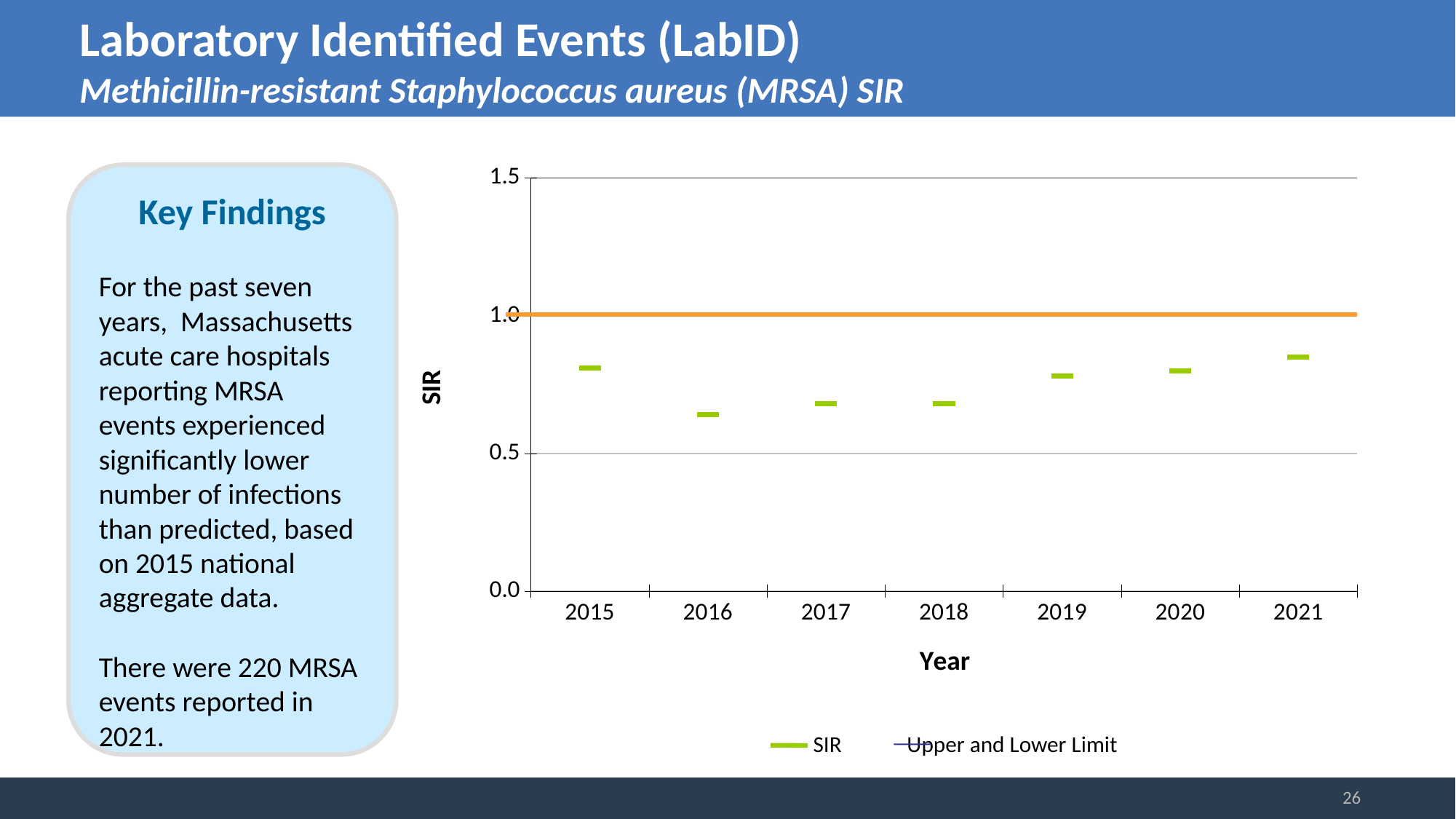
Is the SIR value for 2021 greater or less than 1.0? less What is the label of the chart's x axis? Year At what SIR value does the orange Upper and Lower Limit line sit? 1.0 Which year has the lowest SIR value in the chart? 2016 Do the SIR values rise or fall from 2018 to 2021? rise Is the SIR value for 2016 greater or less than 0.5? greater Which year has the highest SIR value in the chart? 2021 How many years are plotted on the x axis of the chart? 7 How many series does the chart legend list? 2 Which year has a higher SIR value, 2015 or 2017? 2015 Is the SIR value for 2015 greater or less than 1.0? less Which year has a higher SIR value, 2016 or 2019? 2019